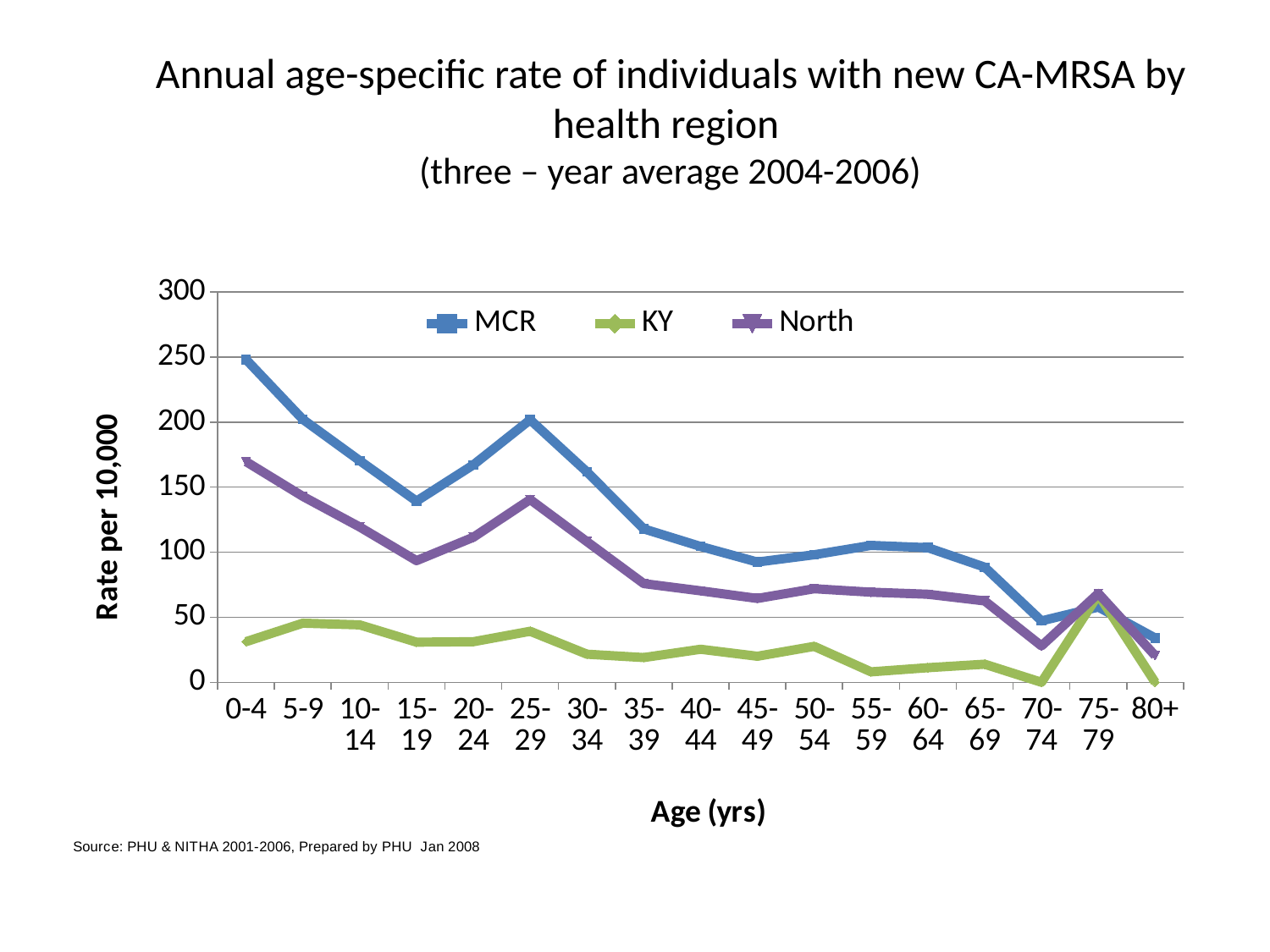
Is the MCR value for the 0-4 age group greater or less than 200? greater Is the North value for the 0-4 age group greater or less than 150? greater How many age groups are shown on the x axis? 17 Is the MCR value for the 35-39 age group greater or less than 100? greater Which age group has the highest KY rate? 75-79 What is the title of the y axis? Rate per 10,000 What kind of chart is shown on the slide? line chart For the 25-29 age group, which series has the larger value, MCR or North? MCR Which age group has the highest MCR rate? 0-4 How many series does the legend list? 3 Does the MCR rate rise or fall from the 0-4 age group to the 15-19 age group? fall